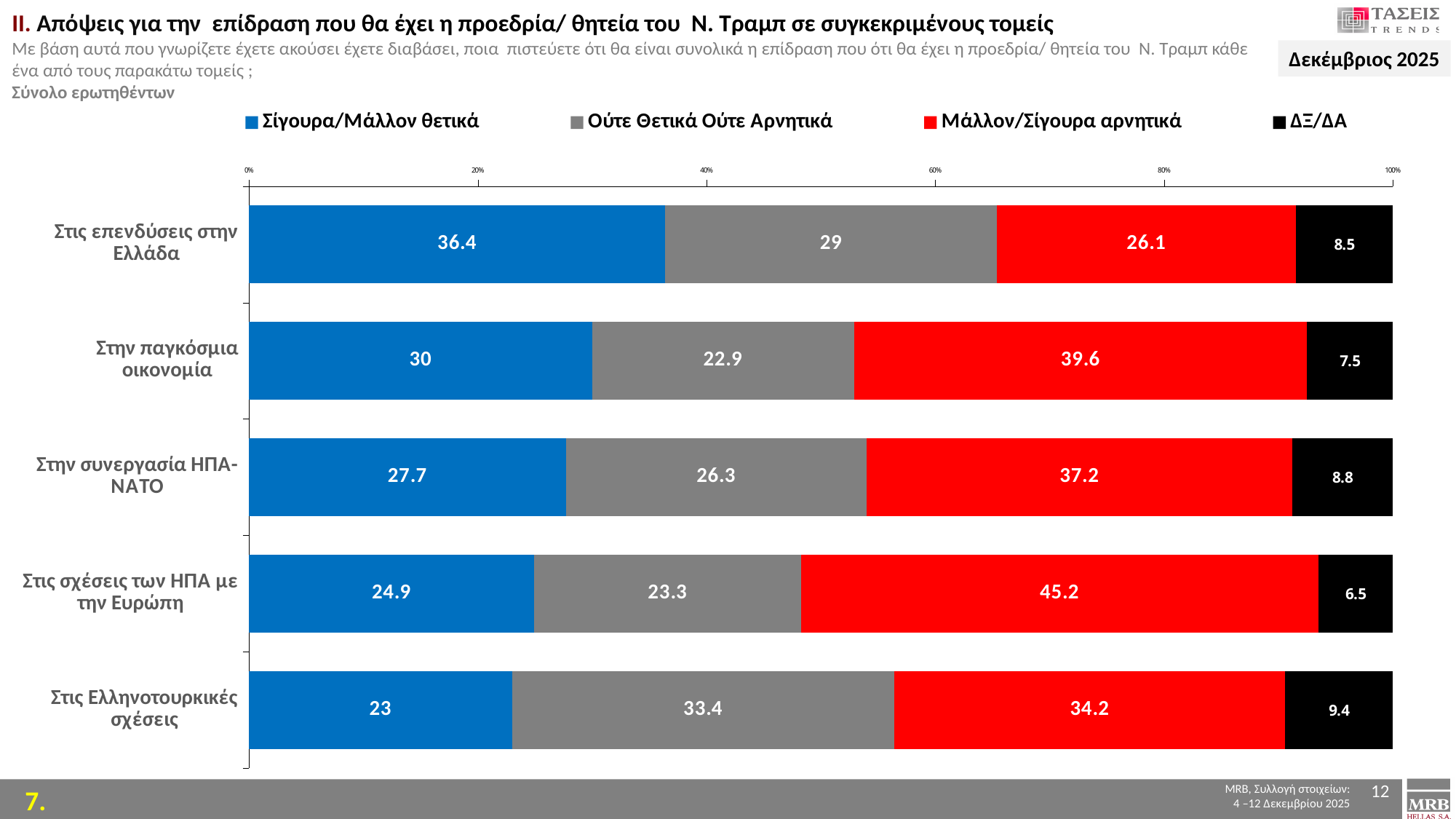
What kind of chart is shown on the slide? Stacked bar chart Which colour represents "ΔΞ/ΔΑ" in the legend? Black What is the total of the stacked bar for "Στην συνεργασία ΗΠΑ-ΝΑΤΟ"? 100 Which category has the highest value for "Μάλλον/Σίγουρα αρνητικά"? Στις σχέσεις των ΗΠΑ με την Ευρώπη What is the value of "ΔΞ/ΔΑ" for "Στις Ελληνοτουρκικές σχέσεις"? 9.4 Which category has the lowest value for "Σίγουρα/Μάλλον θετικά"? Στις Ελληνοτουρκικές σχέσεις Which is larger for "Στις Ελληνοτουρκικές σχέσεις": "Ούτε Θετικά Ούτε Αρνητικά" or "Μάλλον/Σίγουρα αρνητικά"? Μάλλον/Σίγουρα αρνητικά How many series does the legend list? 4 What is the value of "Μάλλον/Σίγουρα αρνητικά" for "Στις σχέσεις των ΗΠΑ με την Ευρώπη"? 45.2 How many categories are shown on the chart? 5 What is the value of "Σίγουρα/Μάλλον θετικά" for "Στις επενδύσεις στην Ελλάδα"? 36.4 What is the difference between the "Μάλλον/Σίγουρα αρνητικά" values for "Στην παγκόσμια οικονομία" and "Στις επενδύσεις στην Ελλάδα"? 13.5